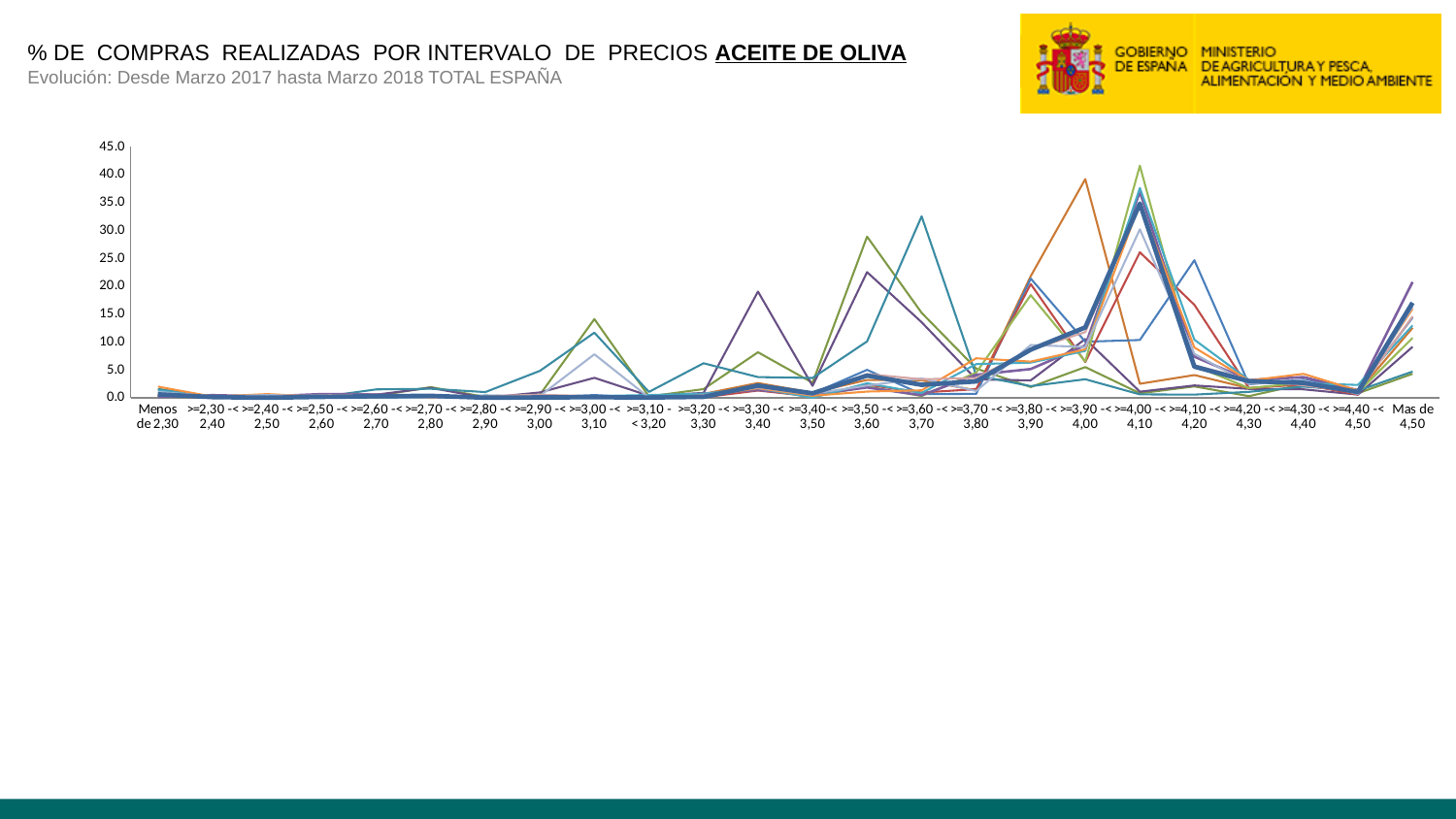
What is the last category label on the x axis? Mas de 4,50 What is the first category label on the x axis? Menos de 2,30 In which price interval does the highest peak of any line occur? >=4,00 -< 4,10 How many price intervals (categories) are shown along the x axis? 24 Is the highest value reached by any line in the >=3,90 -< 4,00 interval greater or less than 35? greater What is the highest tick value shown on the y axis? 45.0 Is the highest value reached by any line in the >=4,00 -< 4,10 interval greater or less than 40? greater What kind of chart is shown on the slide? line chart